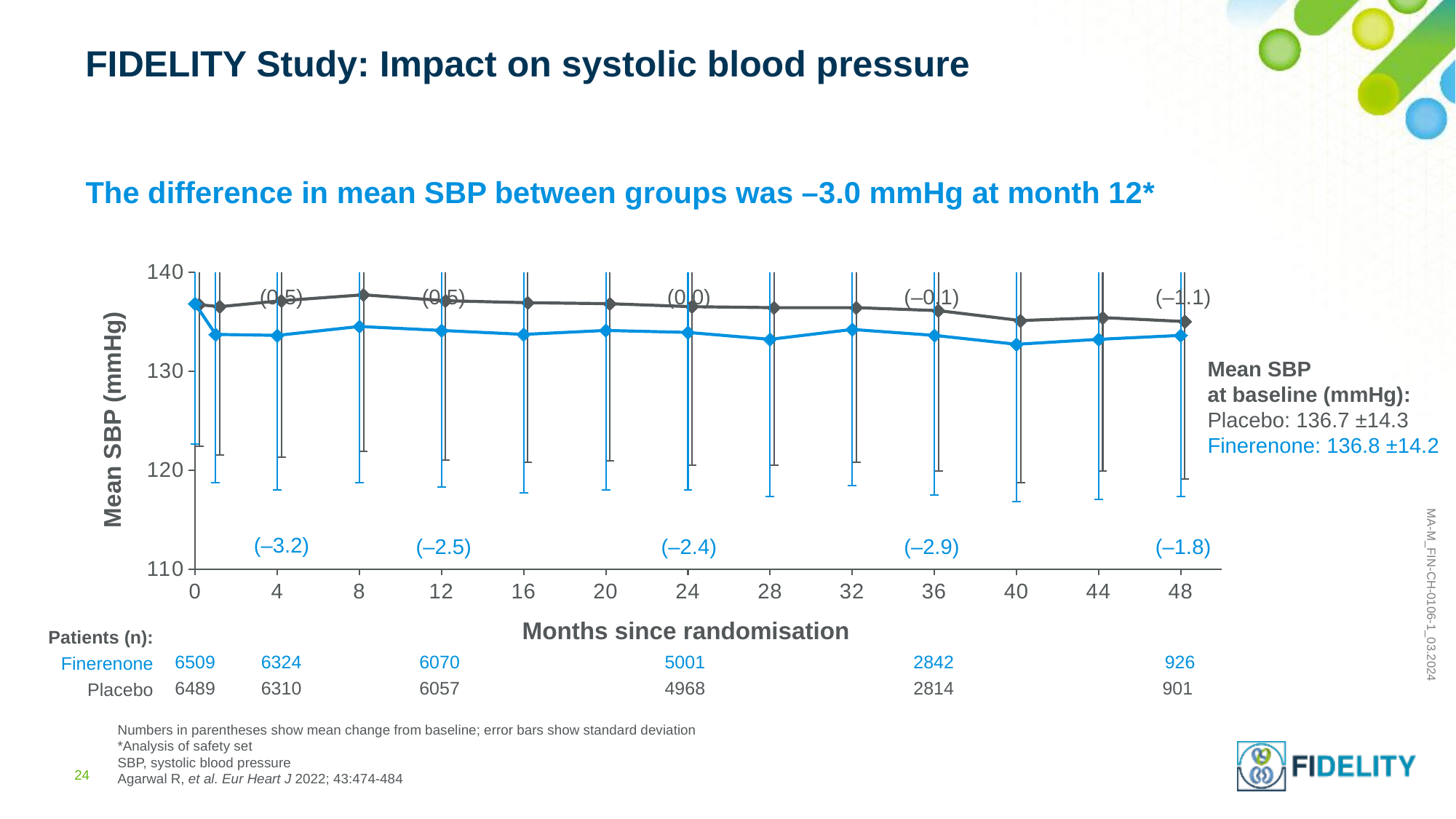
What is the difference between the printed mean change from baseline for finerenone (–1.8) and placebo (–1.1) at month 48? 0.7 What kind of chart is shown on the slide? line chart What is the mean change from baseline in SBP for finerenone at month 4, as printed in parentheses? –3.2 Is the mean SBP for placebo at month 8 greater or less than 140 mmHg? less How many tick labels are shown on the x axis (Months since randomisation)? 13 What is the mean change from baseline in SBP for placebo at month 48, as printed in parentheses? –1.1 At month 12, which group has the higher mean SBP on the chart, finerenone or placebo? Placebo What is the mean change from baseline in SBP for finerenone at month 12, as printed in parentheses? –2.5 Is the mean SBP for finerenone at month 40 greater or less than 130 mmHg? greater Among the printed mean change values for finerenone, at which month is the change most negative? Month 4 (–3.2) What is the title of the y axis of the chart? Mean SBP (mmHg) Does the placebo mean SBP line rise or fall between month 12 and month 48? fall